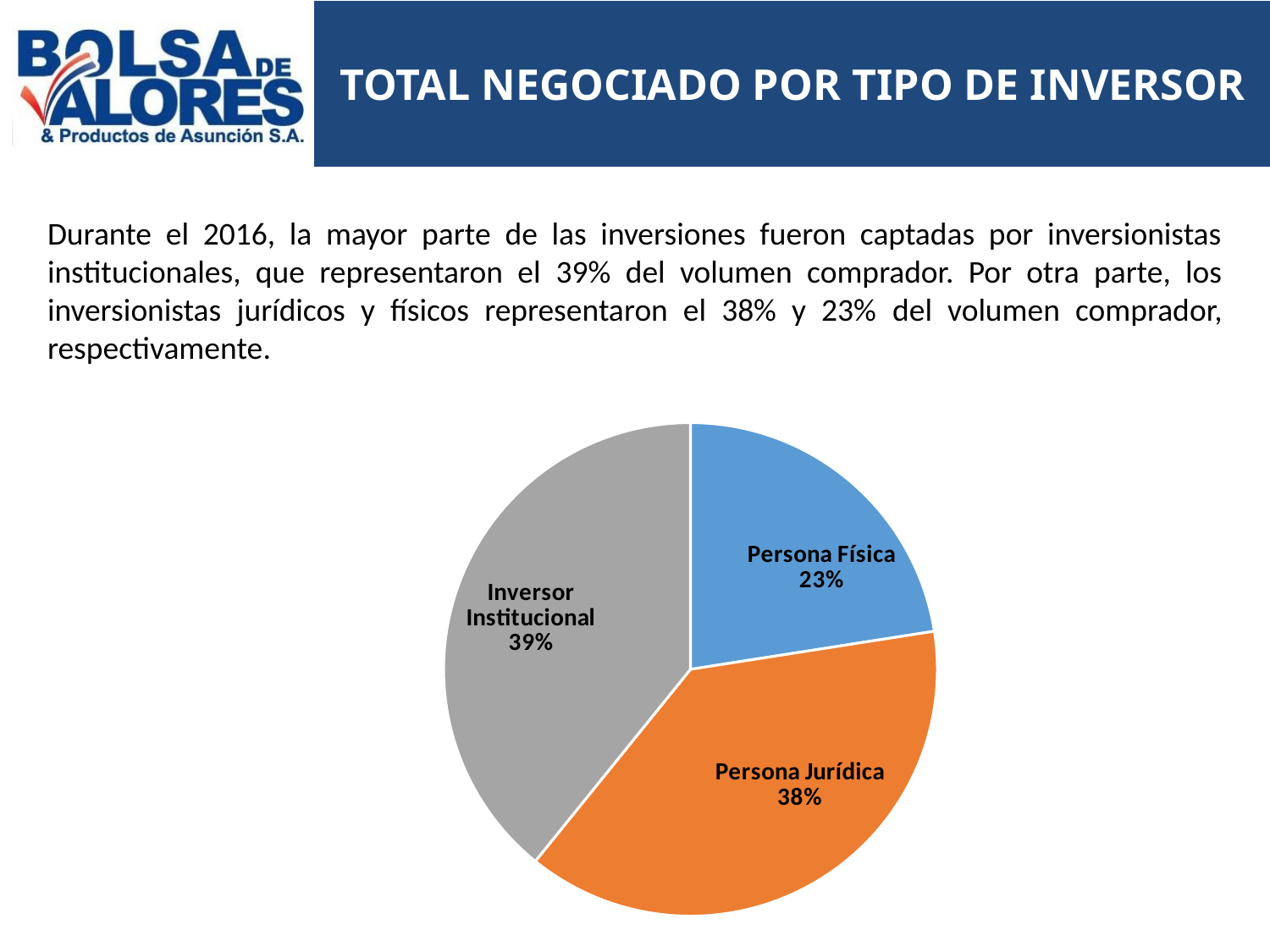
What share of the pie does Persona Jurídica represent? 38% What share of the pie does Inversor Institucional represent? 39% Which category has the smallest slice of the pie? Persona Física What is the difference in percentage points between Inversor Institucional and Persona Física? 16% What colour is the Persona Jurídica slice? Orange What is the difference in percentage points between Persona Jurídica and Persona Física? 15% What share of the pie does Persona Física represent? 23% How many slices does the pie chart have? 3 What is the combined share of Persona Física and Persona Jurídica? 61% What is the title of the slide containing the chart? TOTAL NEGOCIADO POR TIPO DE INVERSOR What kind of chart is shown on the slide? Pie chart Which is larger, the slice for Persona Física or the slice for Persona Jurídica? Persona Jurídica